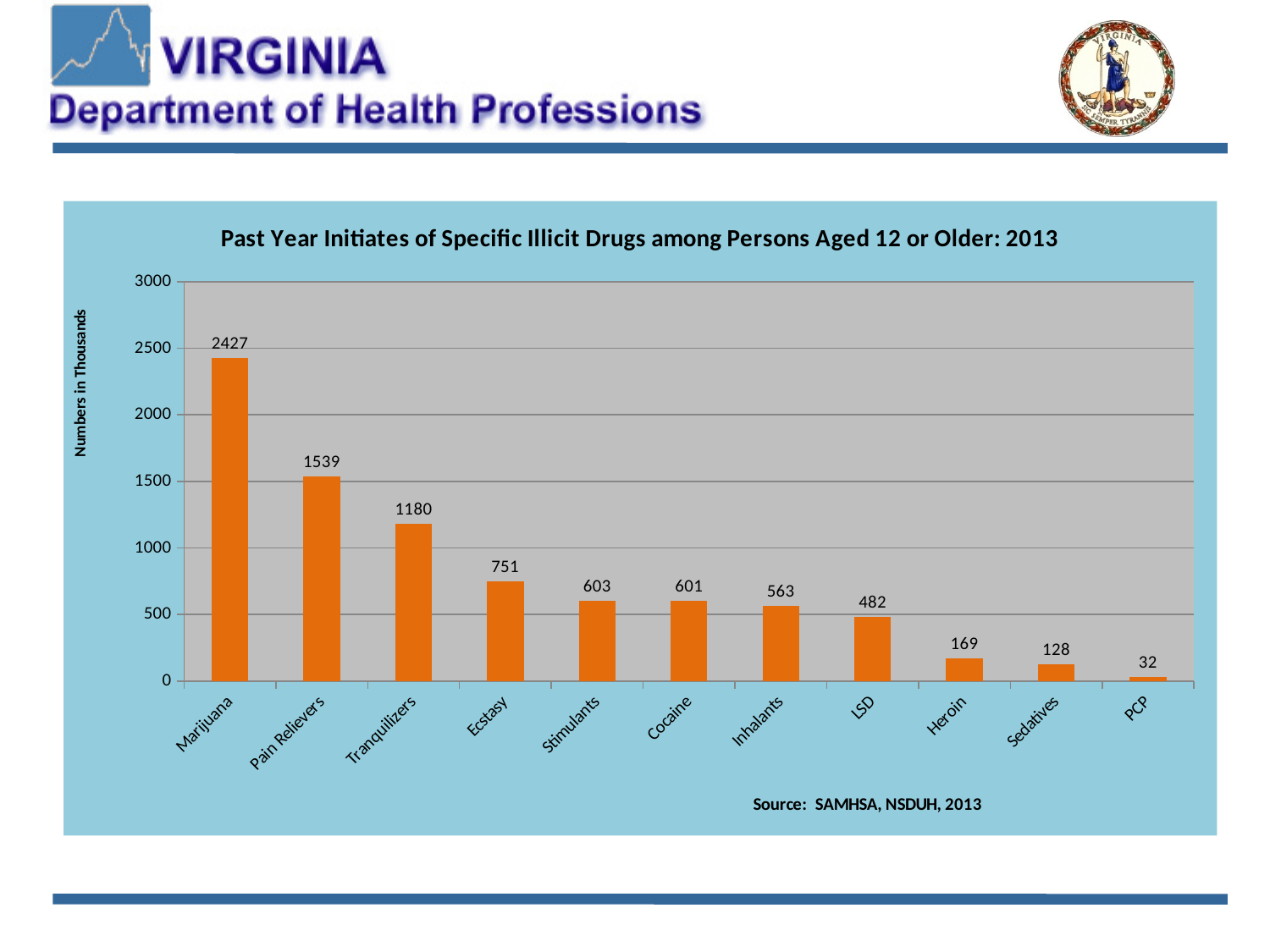
What is the y-axis label of the chart? Numbers in Thousands What is the value for Heroin? 169 What is the difference between the values for Ecstasy and LSD? 269 Is the value for Pain Relievers greater or less than 1500? greater Which category has the lowest value? PCP Which category has the highest value? Marijuana What is the value for Tranquilizers? 1180 What is the difference between the values for Marijuana and Pain Relievers? 888 What is the value for Marijuana? 2427 Which is larger, the value for Inhalants or the value for LSD? Inhalants What kind of chart is shown on the slide? Bar chart How many categories are shown on the x axis? 11